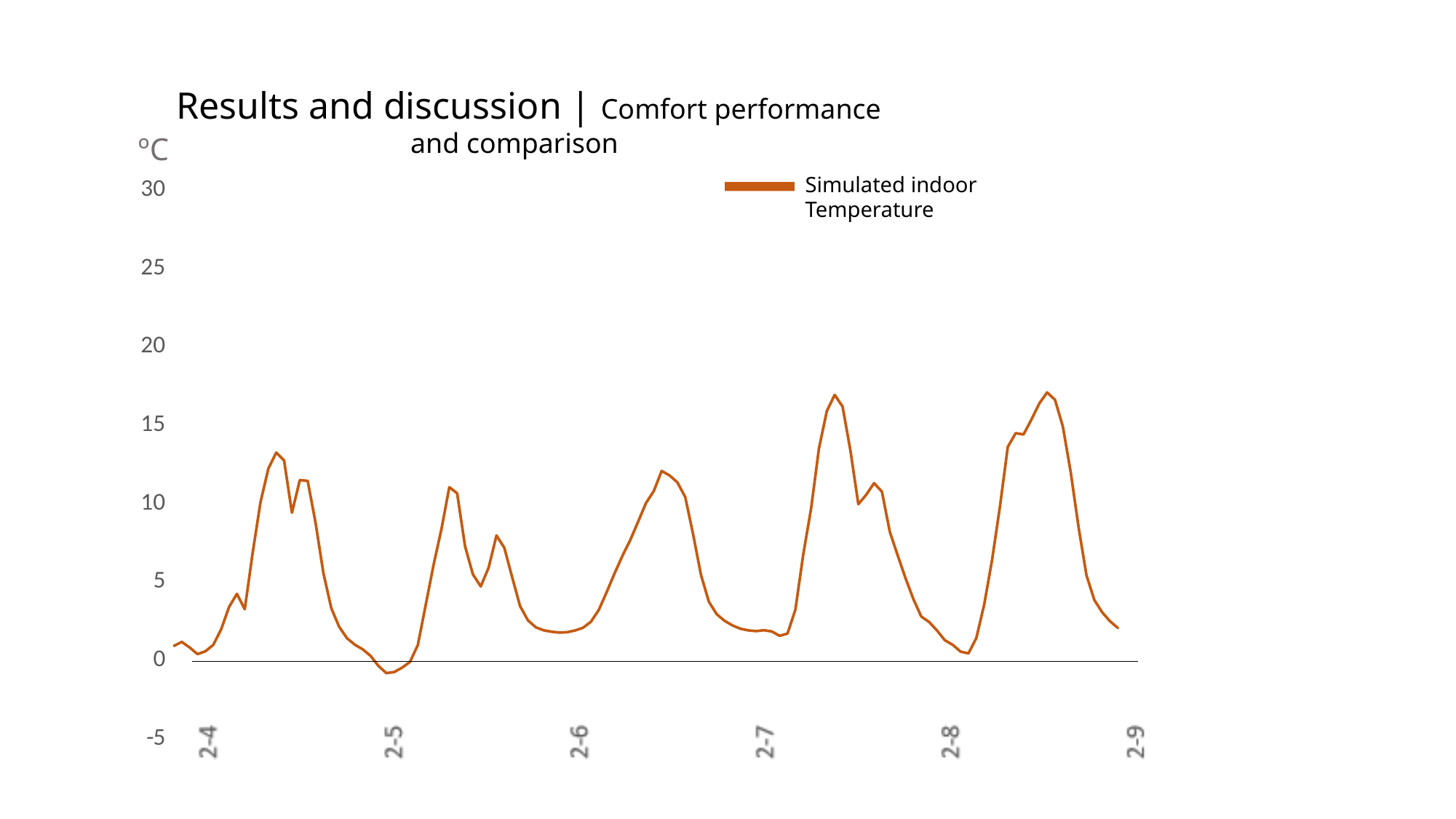
Is the highest peak of the simulated indoor temperature greater or less than 15? greater What unit is shown on the vertical axis? °C How many series does the legend list? 1 Is the peak of the simulated indoor temperature between 2-6 and 2-7 greater or less than 15? less Is the peak of the simulated indoor temperature between 2-4 and 2-5 greater or less than 10? greater How many date labels are shown on the horizontal axis? 6 What is the name of the series shown in the legend? Simulated indoor Temperature What kind of chart is shown on the slide? line chart